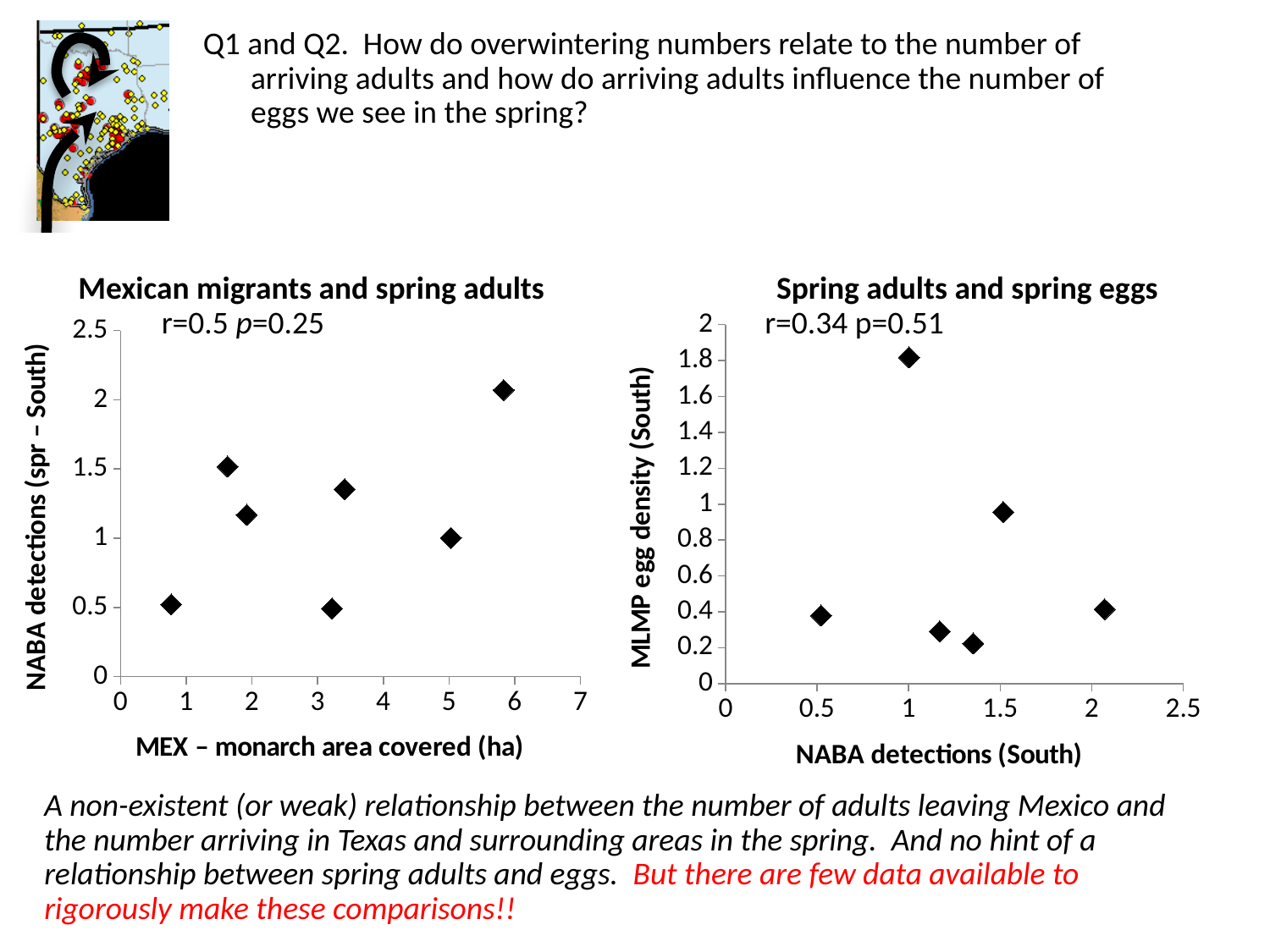
How many data points are plotted in the 'Mexican migrants and spring adults' chart? 7 In the 'Mexican migrants and spring adults' chart, is the NABA detections value for the point with the largest MEX area greater or less than 1.5? greater How many data points are plotted in the 'Spring adults and spring eggs' chart? 6 What correlation coefficient is shown on the 'Spring adults and spring eggs' chart? r=0.34 In the 'Spring adults and spring eggs' chart, is the highest MLMP egg density value greater or less than 1.6? greater What is the x-axis title of the 'Mexican migrants and spring adults' chart? MEX – monarch area covered (ha) In the 'Mexican migrants and spring adults' chart, is the highest NABA detections value greater or less than 2? greater What kind of chart is the 'Mexican migrants and spring adults' chart? scatter chart What kind of chart is the 'Spring adults and spring eggs' chart? scatter chart In the 'Mexican migrants and spring adults' chart, what is the maximum value shown on the x axis? 7